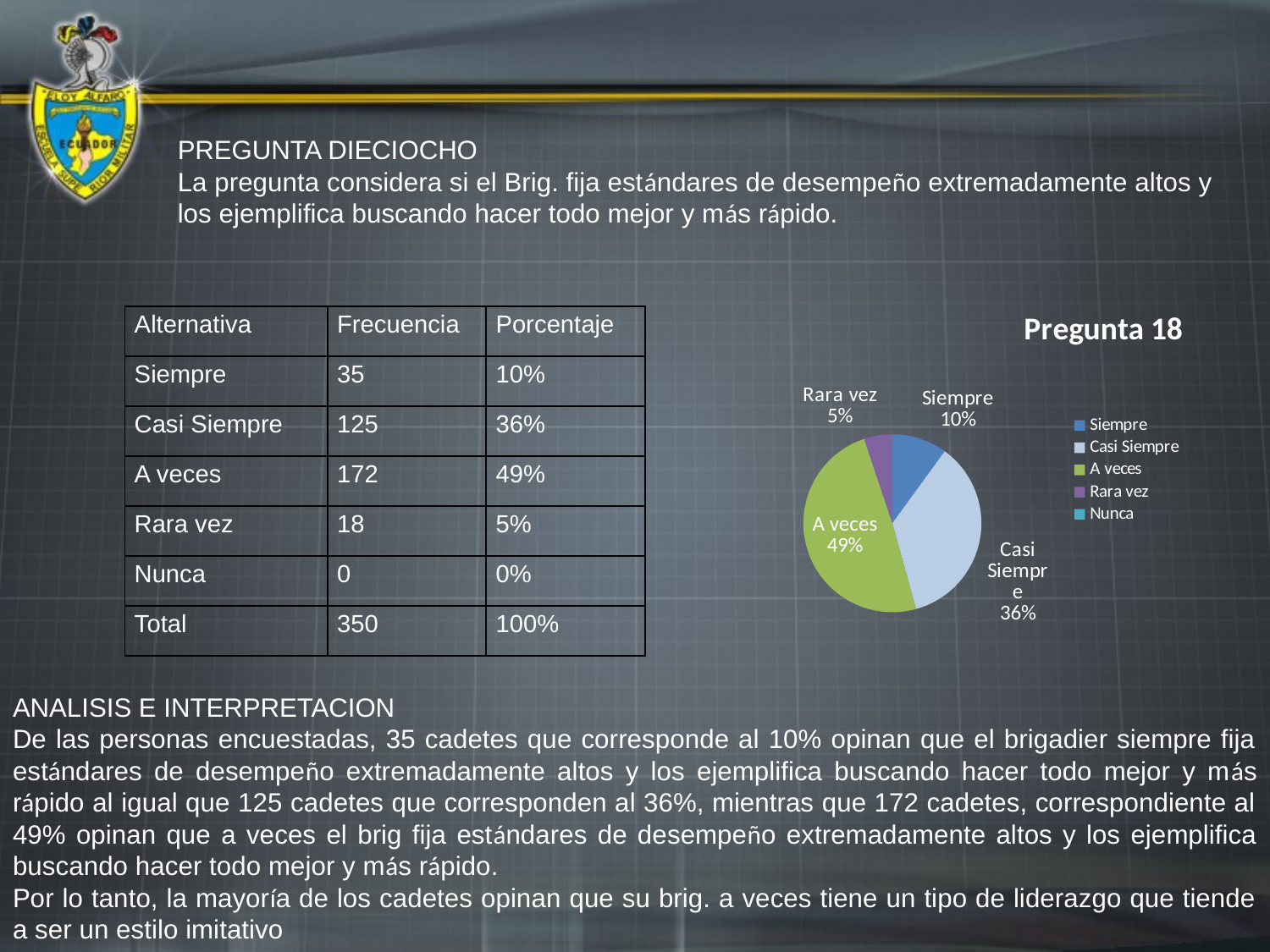
What share of the pie does the 'A veces' slice represent? 49% How many entries does the chart legend list? 5 What share of the pie does the 'Rara vez' slice represent? 5% What kind of chart is shown on the slide? pie chart What is the combined share of the 'Siempre' and 'Rara vez' slices? 15% What share of the pie does the 'Siempre' slice represent? 10% Which labelled slice of the pie is the smallest? Rara vez What is the title of the chart? Pregunta 18 What is the difference in percentage points between the 'A veces' and 'Casi Siempre' slices? 13% Which category has the largest slice of the pie? A veces Which slice is larger, 'Casi Siempre' or 'Siempre'? Casi Siempre